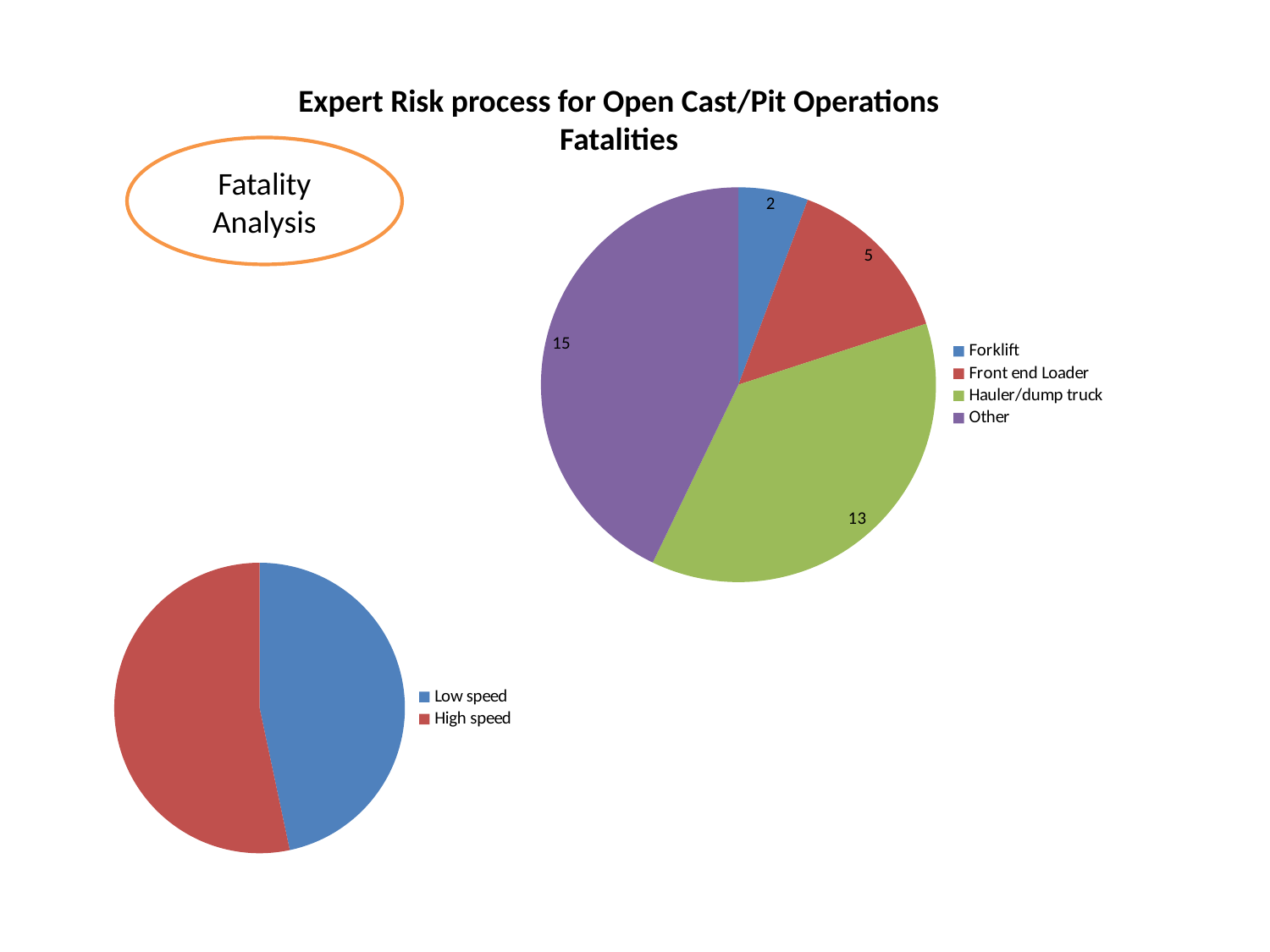
In the chart titled 'Expert Risk process for Open Cast/Pit Operations Fatalities', what is the value for Forklift? 2 In the bottom-left pie chart, what colour is the High speed slice? Red In the chart titled 'Expert Risk process for Open Cast/Pit Operations Fatalities', what is the total of all slices? 35 In the chart titled 'Expert Risk process for Open Cast/Pit Operations Fatalities', what is the difference between the values for Other and Hauler/dump truck? 2 In the chart titled 'Expert Risk process for Open Cast/Pit Operations Fatalities', what is the value for Front end Loader? 5 What kind of chart is the one at the bottom left of the slide? Pie chart How many categories does the legend of the bottom-left pie chart list? 2 In the chart titled 'Expert Risk process for Open Cast/Pit Operations Fatalities', what is the value for Hauler/dump truck? 13 In the chart titled 'Expert Risk process for Open Cast/Pit Operations Fatalities', how many categories are shown? 4 In the chart titled 'Expert Risk process for Open Cast/Pit Operations Fatalities', which category has the largest slice? Other In the chart titled 'Expert Risk process for Open Cast/Pit Operations Fatalities', which is larger, Front end Loader or Hauler/dump truck? Hauler/dump truck In the chart titled 'Expert Risk process for Open Cast/Pit Operations Fatalities', which category has the smallest slice? Forklift